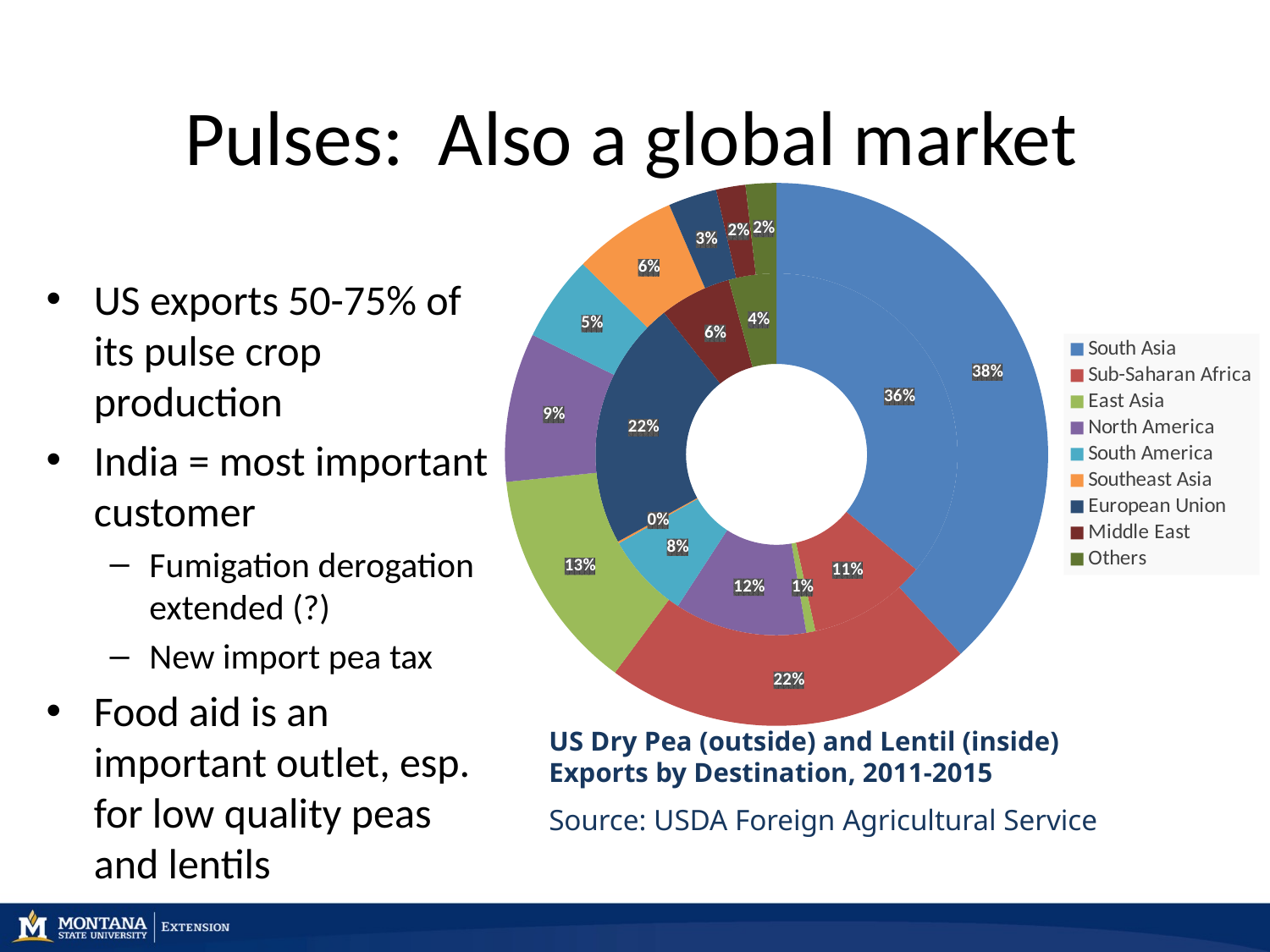
What share of US lentil exports (inside ring) went to East Asia? 1% How many destination regions does the chart legend list? 9 Which destination has the smallest share of US lentil exports (inside ring)? Southeast Asia What is the title of the chart? US Dry Pea (outside) and Lentil (inside) Exports by Destination, 2011-2015 What share of US dry pea exports (outside ring) went to South Asia? 38% What kind of chart is shown on the slide? Doughnut chart Which is larger: the North America share of dry pea exports (outside ring) or the North America share of lentil exports (inside ring)? Lentil exports (12%) What share of US lentil exports (inside ring) went to the European Union? 22% What is the difference between the East Asia share of dry pea exports (13%) and the East Asia share of lentil exports (1%)? 12 percentage points Which destination has the largest share of US dry pea exports (outside ring)? South Asia How many percentage points larger is the South Asia share of dry pea exports (38%) than the South Asia share of lentil exports (36%)? 2 percentage points What share of US dry pea exports (outside ring) went to Sub-Saharan Africa? 22%